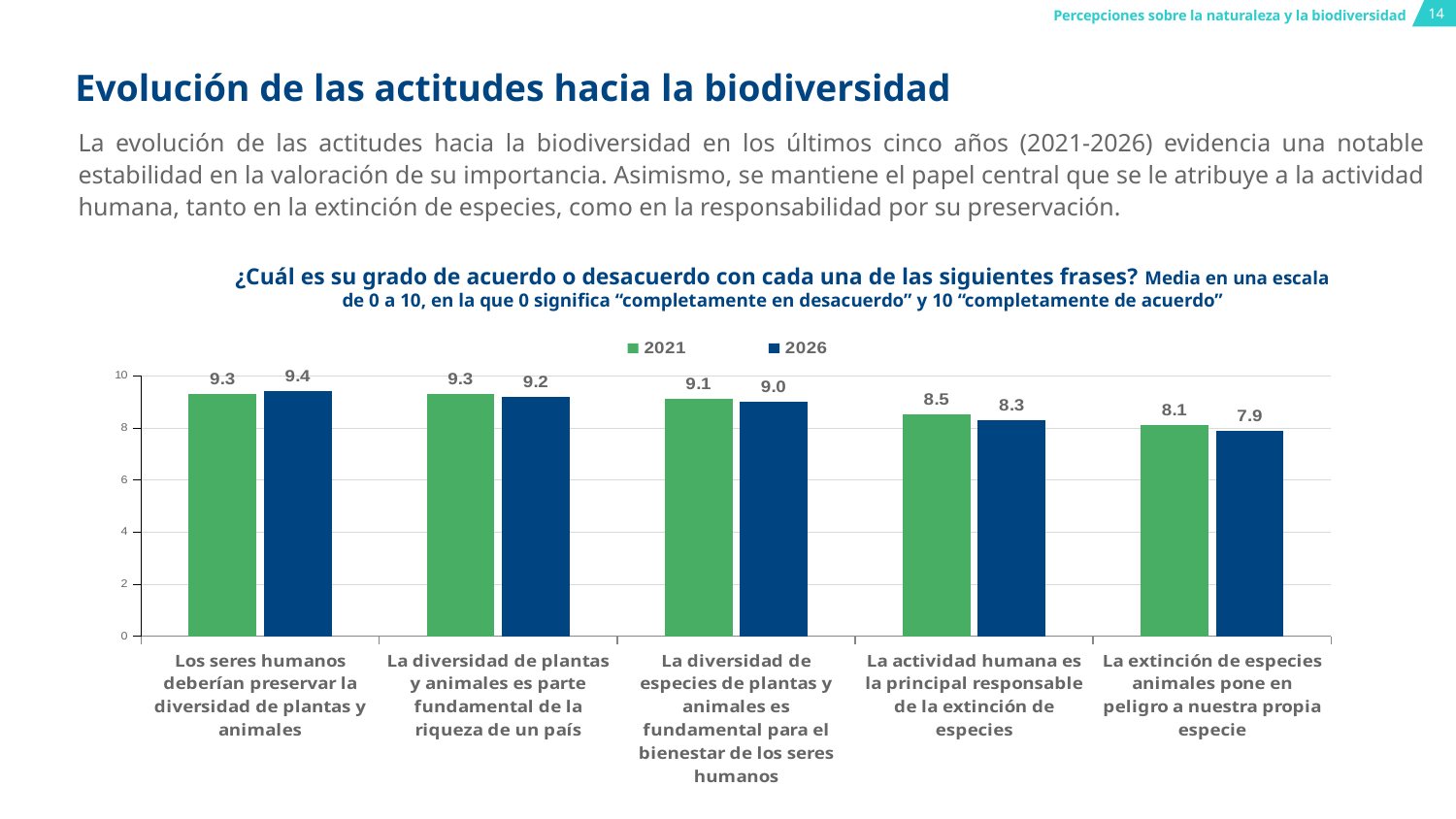
For "La diversidad de plantas y animales es parte fundamental de la riqueza de un país", which year has the larger value, 2021 or 2026? 2021 How many statements (categories) are shown on the x axis? 5 Which statement has the highest 2026 value? Los seres humanos deberían preservar la diversidad de plantas y animales Which years are listed in the chart legend? 2021 and 2026 What is the 2026 value for "La actividad humana es la principal responsable de la extinción de especies"? 8.3 What is the difference between the 2021 and 2026 values for "La actividad humana es la principal responsable de la extinción de especies"? 0.2 Which statement has the lowest 2021 value? La extinción de especies animales pone en peligro a nuestra propia especie What is the 2021 value for "Los seres humanos deberían preservar la diversidad de plantas y animales"? 9.3 What is the 2026 value for "La extinción de especies animales pone en peligro a nuestra propia especie"? 7.9 How many series does the legend list? 2 What kind of chart is shown on the slide? Bar chart Is the 2026 value for "La extinción de especies animales pone en peligro a nuestra propia especie" greater or less than 8? less